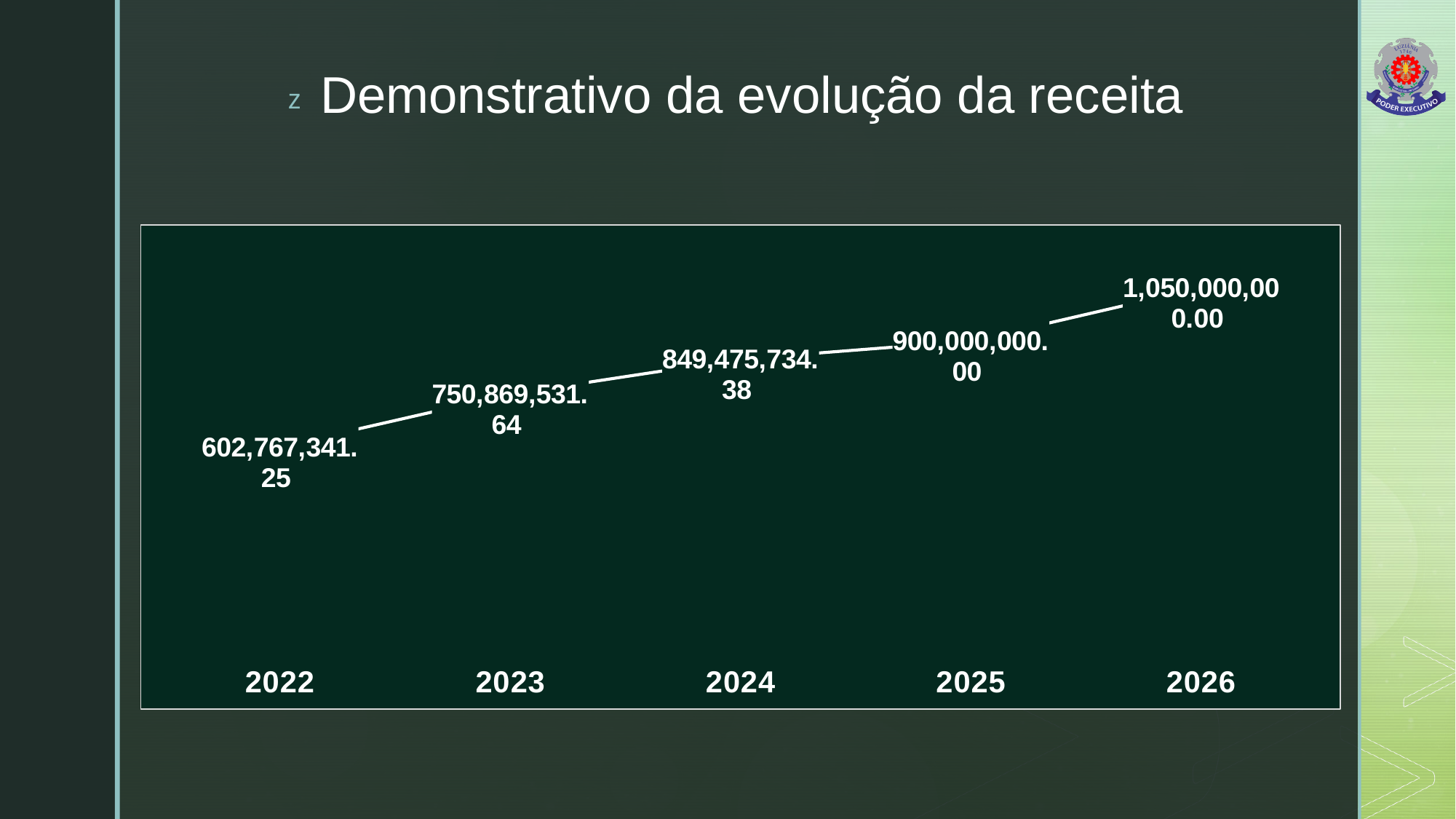
What is the value for 2024? 849,475,734.38 What is the value for 2023? 750,869,531.64 What is the value for 2026? 1,050,000,000.00 What is the value for 2022? 602,767,341.25 Which year has the highest value? 2026 How many years are plotted on the chart? 5 What is the difference between the values for 2025 and 2024? 50,524,265.62 Which year has the lowest value? 2022 What is the difference between the values for 2026 and 2025? 150,000,000.00 Do the values rise or fall from 2022 to 2026? rise Which is larger, the value for 2023 or the value for 2025? 2025 What kind of chart is shown on the slide? line chart